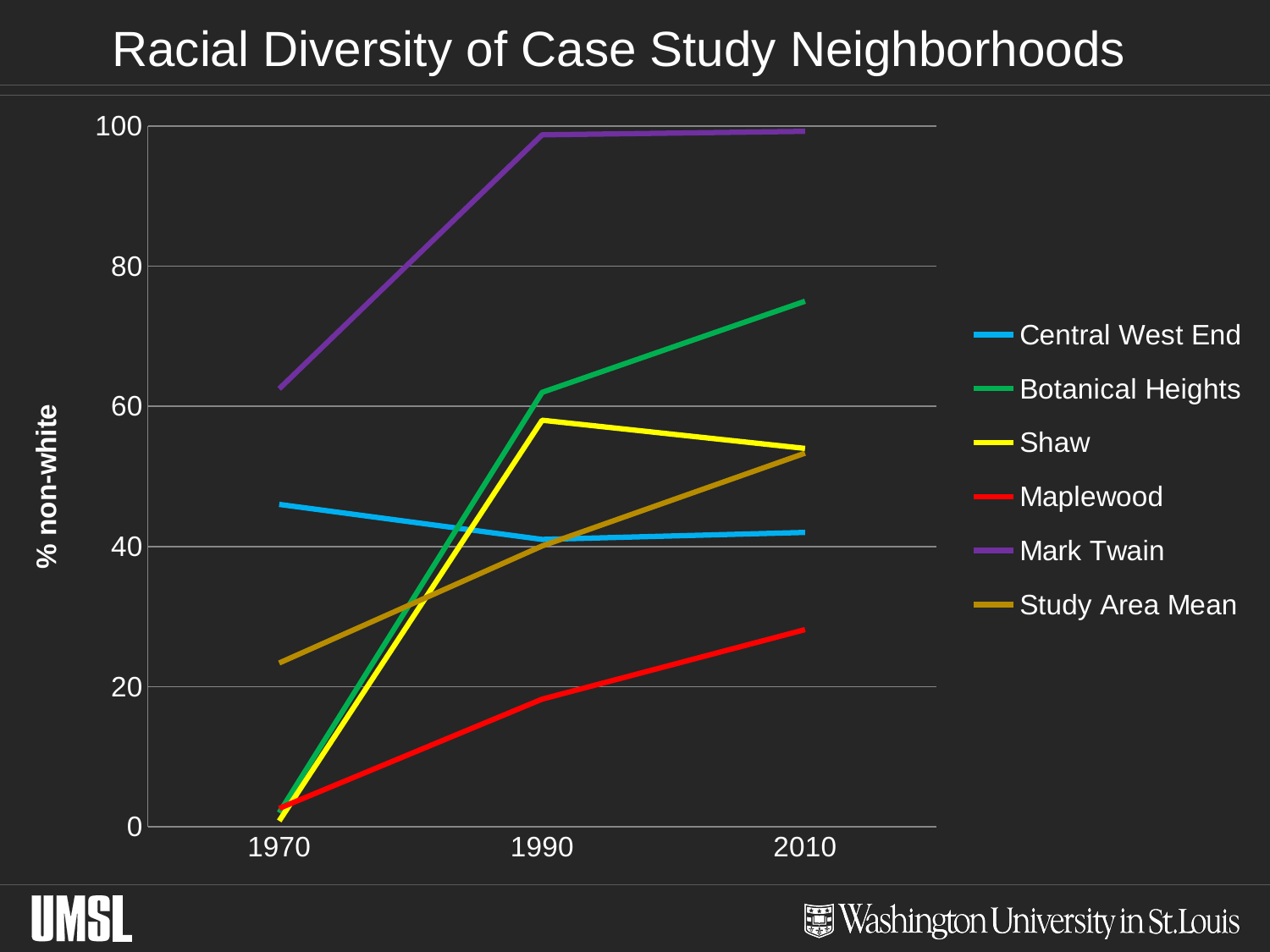
Does the Maplewood line rise or fall from 1970 to 2010? rise Which neighborhood has the lowest % non-white in 2010? Maplewood Is the value for Study Area Mean in 2010 greater or less than 40? greater Is the value for Mark Twain in 1970 greater or less than 80? less Which neighborhood has the highest % non-white in 2010? Mark Twain In 2010, which is larger: Shaw or Central West End? Shaw How many series does the legend list? 6 What is the label on the y axis? % non-white Is the value for Botanical Heights in 2010 greater or less than 60? greater What kind of chart is shown on the slide? line chart Which series has the highest value in 1970? Mark Twain How many years are shown on the x axis? 3